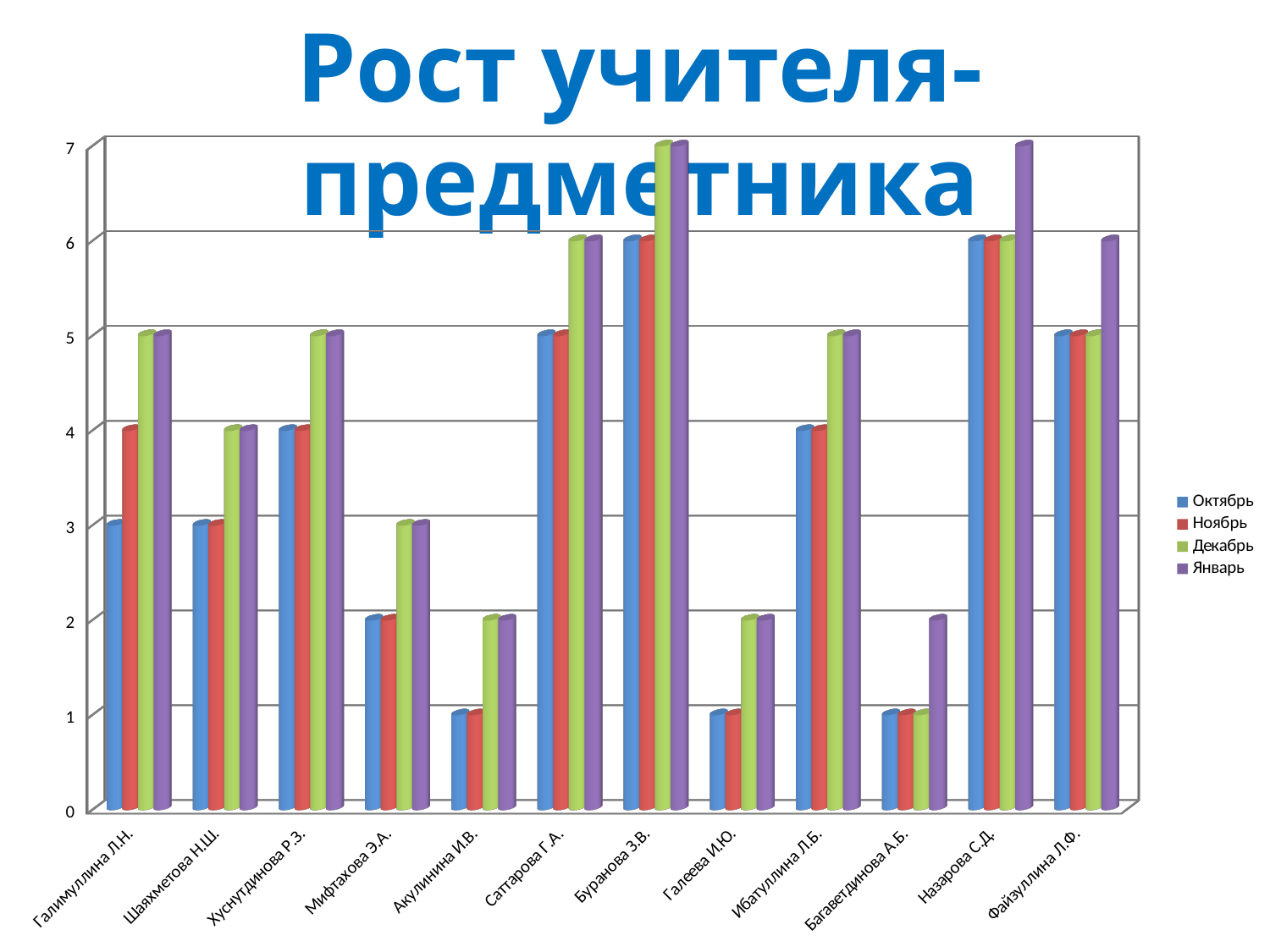
Which series is shown in purple in the legend? Январь Which is larger for Саттарова Г.А.: the Октябрь value or the Декабрь value? Декабрь What is the Январь value for Буранова З.В.? 7 How many series does the legend list? 4 What is the Январь value for Багаветдинова А.Б.? 2 Which teacher has the highest Октябрь value? Буранова З.В. and Назарова С.Д. Is the Январь value for Назарова С.Д. greater or less than 6? greater What kind of chart is shown on the slide? bar chart How many teachers (categories) are shown on the x axis? 12 What is the title of the chart? Рост учителя-предметника What is the Октябрь value for Галимуллина Л.Н.? 3 Do the values for Галимуллина Л.Н. rise or fall from Октябрь to Январь? rise